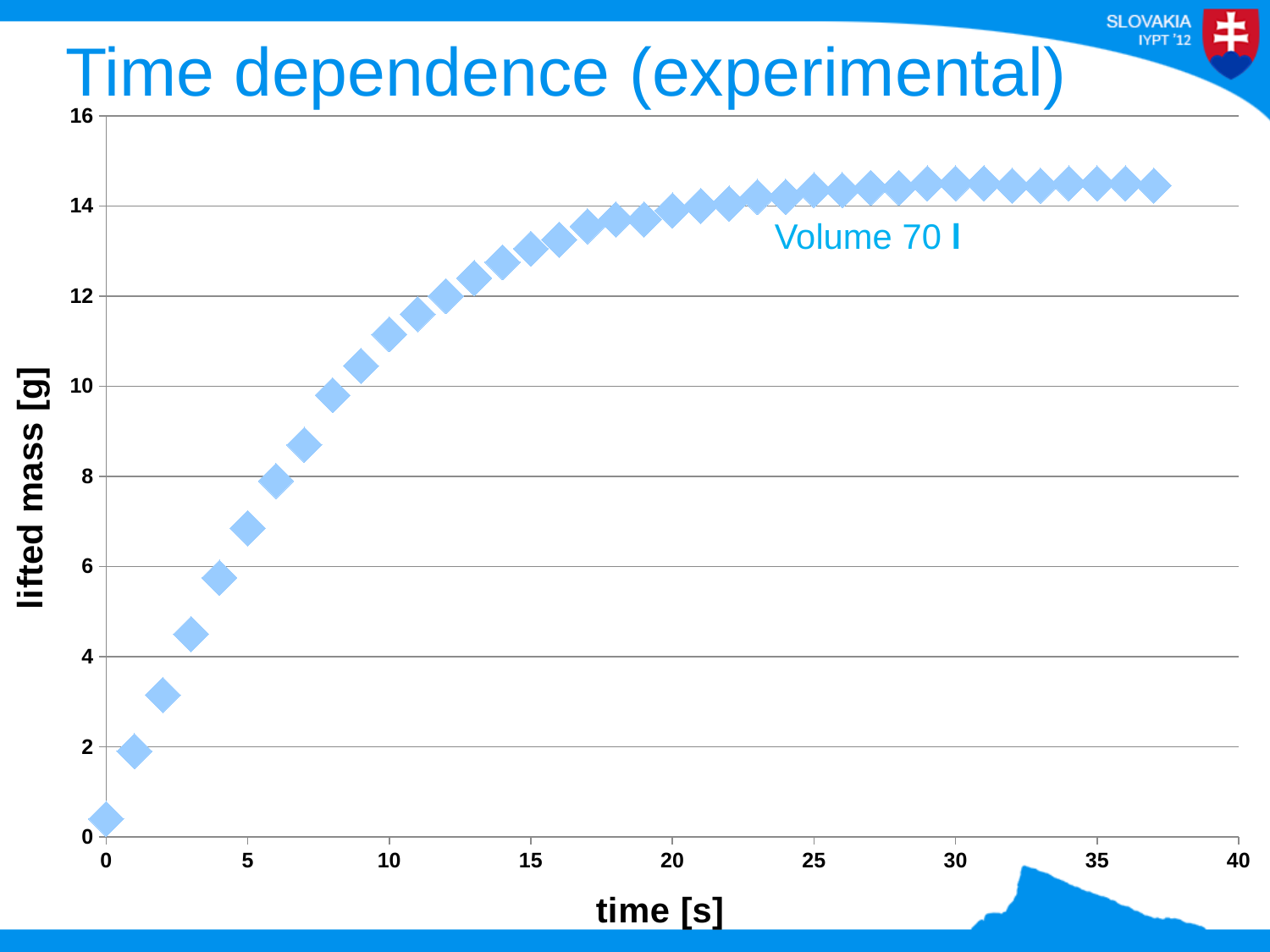
Is the lifted mass at time 30 s greater or less than 14? greater Is the lifted mass at time 10 s greater or less than 10? greater Is the lifted mass at time 5 s greater or less than 8? less What kind of chart is shown on the slide? scatter chart Do the plotted values rise or fall as time increases along the x axis? rise What is the title of the chart? Time dependence (experimental) At which time is the lifted mass lowest? 0 s Which is larger, the lifted mass at time 5 s or at time 10 s? time 10 s What is the label of the vertical axis? lifted mass [g]